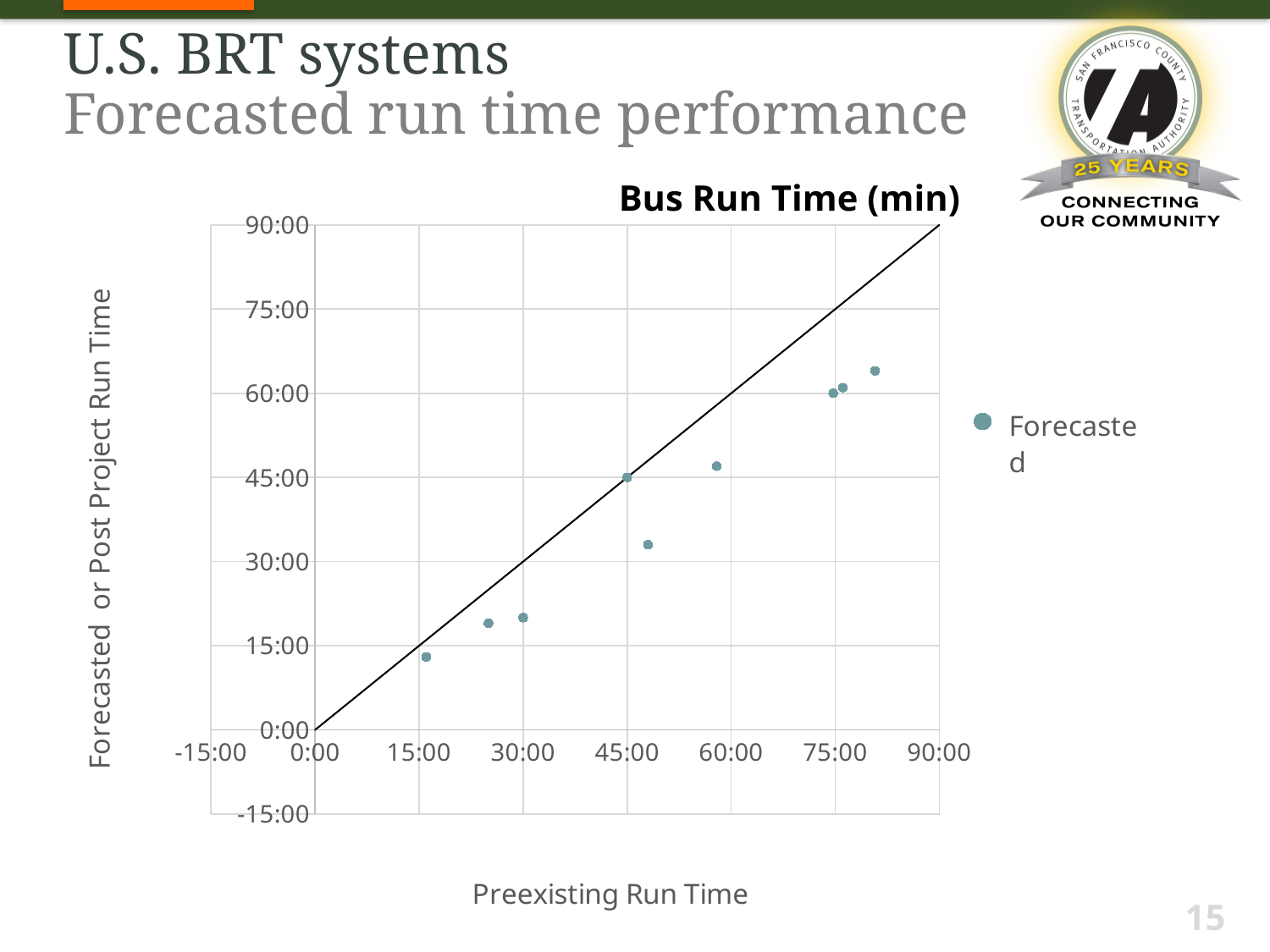
Do the forecasted run times generally rise or fall as the preexisting run time increases? rise Is the forecasted run time for the point with the lowest preexisting run time greater or less than 15:00? less What is the title of the chart? Bus Run Time (min) Is the forecasted run time for the point with a preexisting run time of about 75:00 greater or less than 75:00? less Is the forecasted run time for the point with a preexisting run time of about 30:00 greater or less than 30:00? less How many series does the chart legend list? 1 How many data points are plotted on the chart? 9 What is the label of the horizontal axis? Preexisting Run Time What kind of chart is shown on the slide? scatter chart Does the point with the highest forecasted run time also have the highest preexisting run time? yes